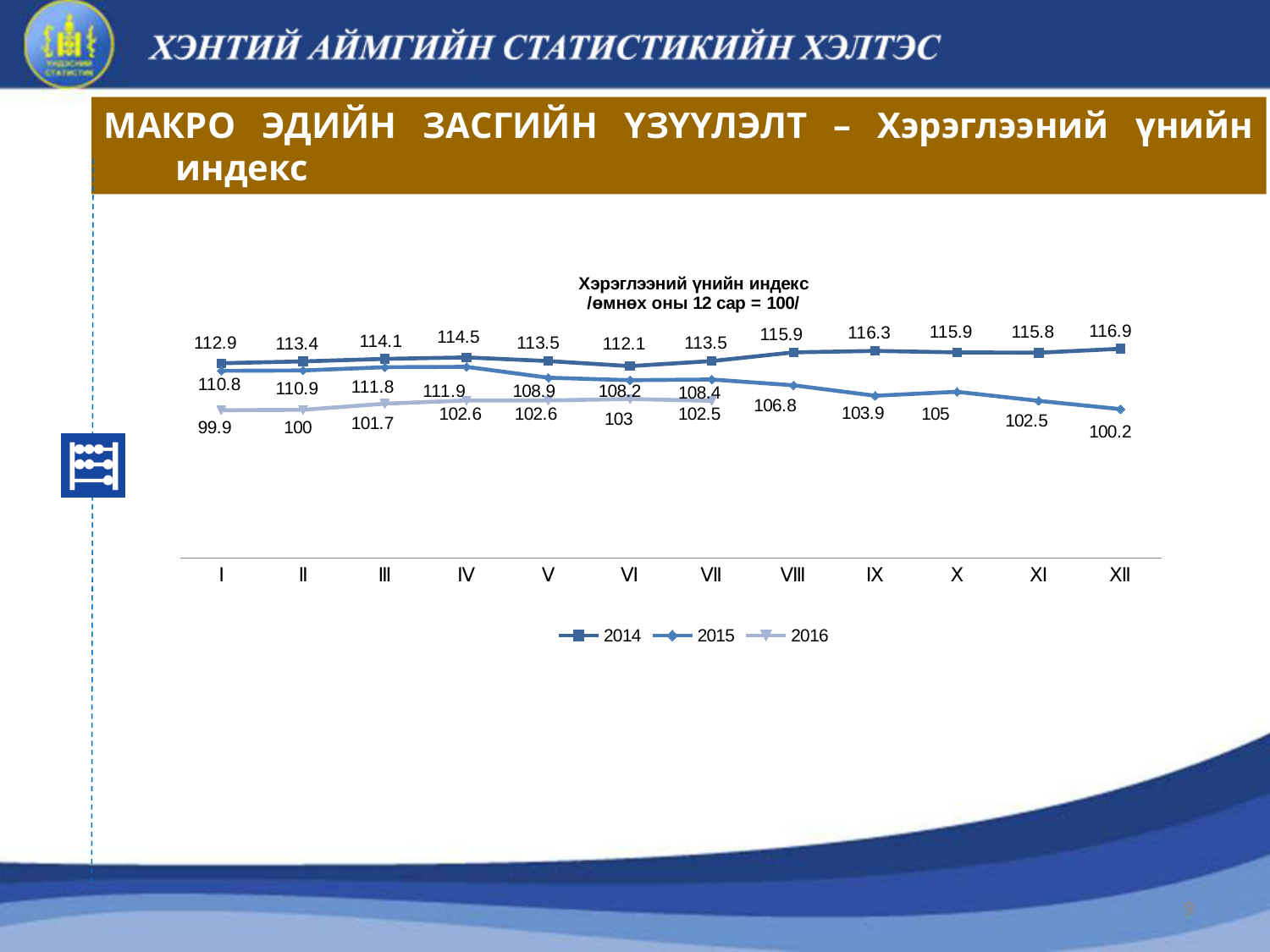
In which month is the 2015 series lowest? XII Does the 2015 series generally rise or fall from month I to month XII? fall In which month is the 2014 series highest? XII How many categories are shown on the x axis? 12 What is the value for 2016 in month III? 101.7 What type of chart is shown on the slide? line chart What is the value for 2015 in month VIII? 106.8 What is the value for 2014 in month XII? 116.9 What is the difference between the 2014 and 2015 values in month IX? 12.4 What is the title of the chart? Хэрэглээний үнийн индекс /өмнөх оны 12 сар = 100/ How many series does the legend list? 3 Which is larger in month I: the 2015 value or the 2016 value? 2015